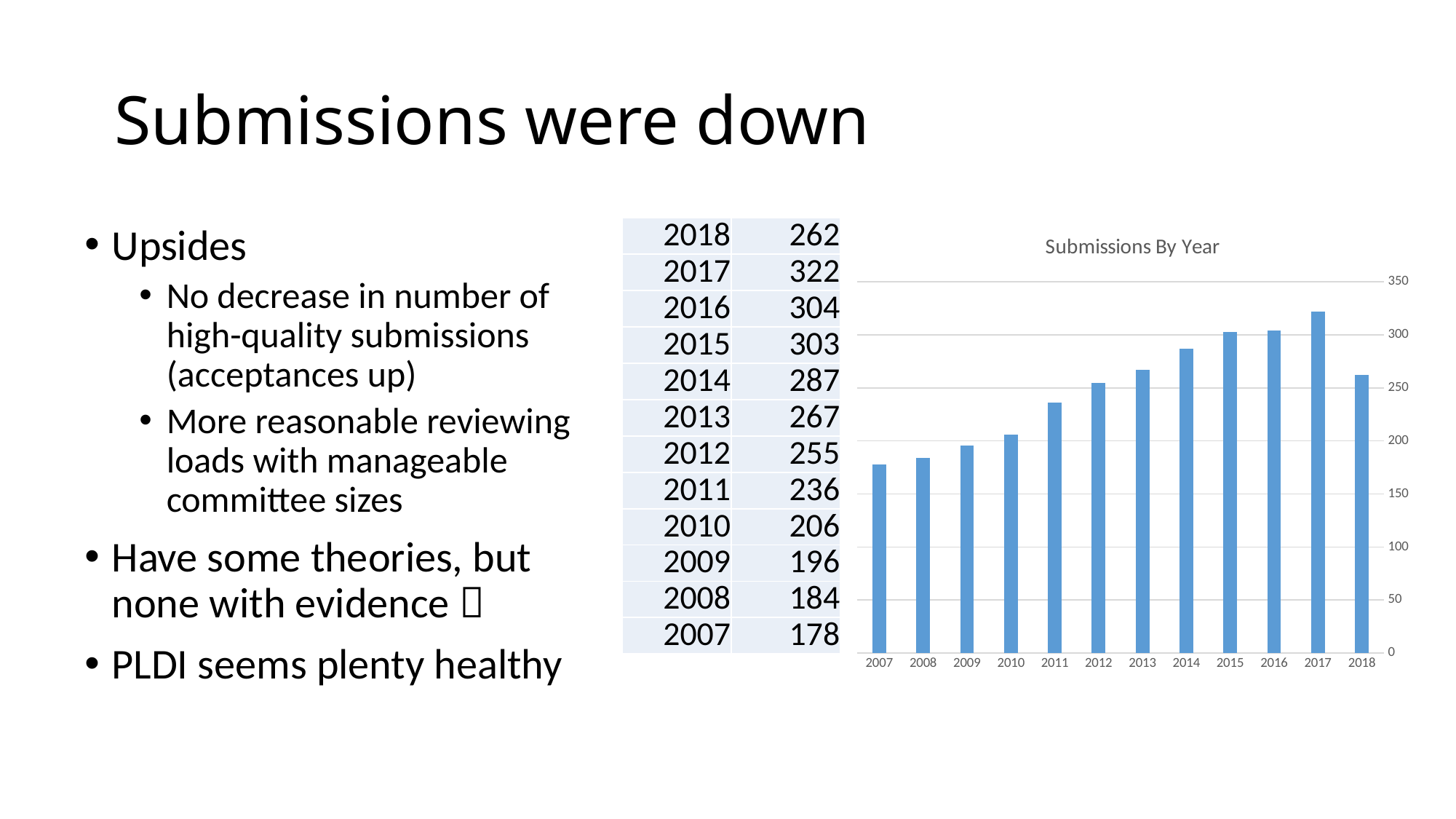
Which year had more submissions, 2014 or 2018? 2014 Using the values in the table, by how much did submissions fall from 2017 to 2018? 60 According to the table next to the chart, how many submissions were there in 2007? 178 Which year has the highest number of submissions in the Submissions By Year chart? 2017 According to the table next to the chart, how many submissions were there in 2018? 262 Which year has the lowest number of submissions in the Submissions By Year chart? 2007 How many years are shown on the x axis of the Submissions By Year chart? 12 According to the table next to the chart, how many submissions were there in 2017? 322 What kind of chart is the Submissions By Year chart? bar chart What is the title of the chart on the slide? Submissions By Year Is the value for 2011 in the Submissions By Year chart greater or less than 250? less